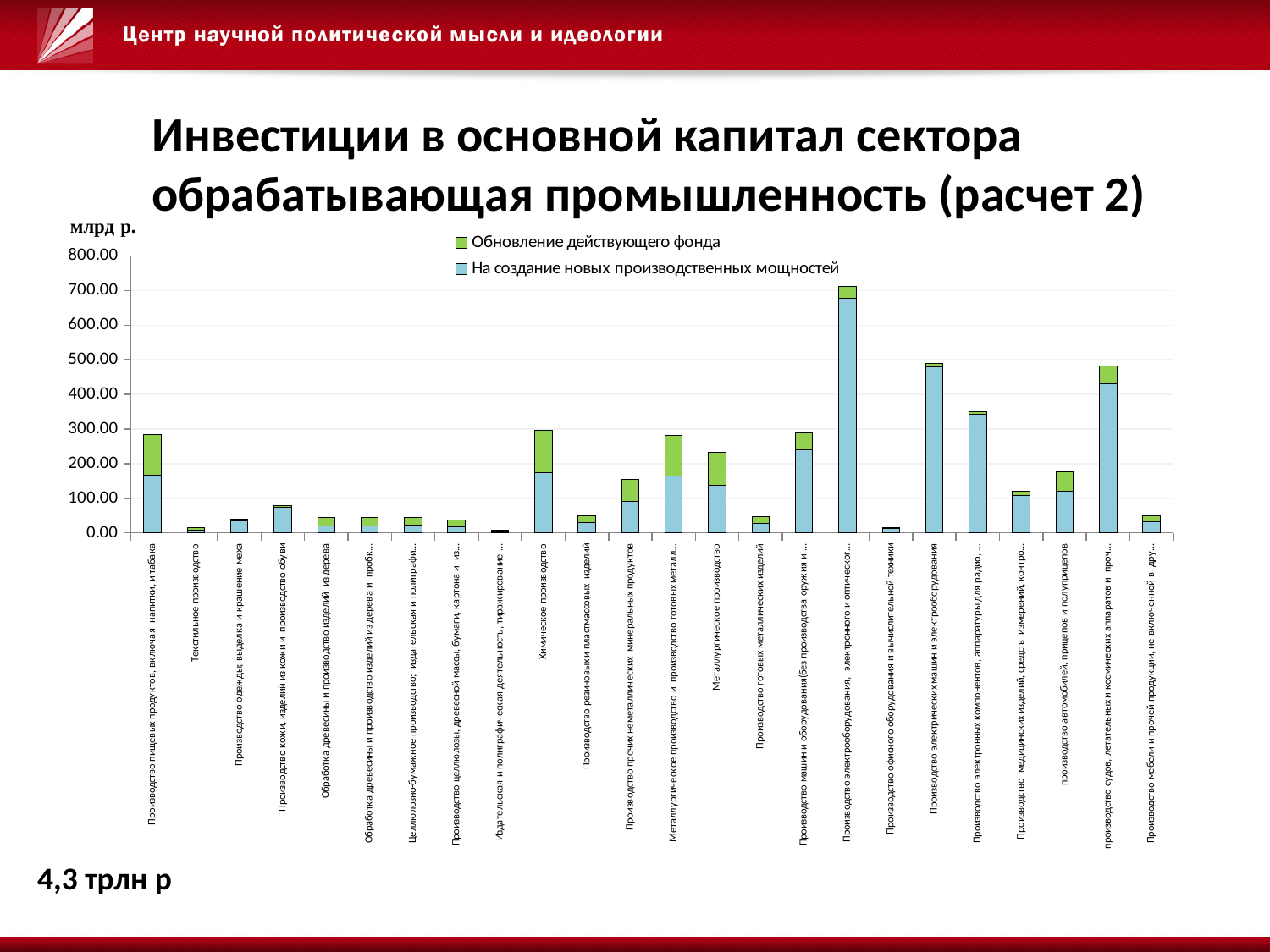
What are the two series named in the chart legend? Обновление действующего фонда; На создание новых производственных мощностей What kind of chart is shown on the slide? Stacked bar chart Which category has the highest total bar on the chart? Производство электрооборудования, электронного и оптического... Is the total value for Производство электрических машин и электрооборудования greater or less than 400? greater Which has the larger total bar: Химическое производство or Металлургическое производство? Химическое производство How many series does the chart legend list? 2 What unit is shown on the vertical axis of the chart? млрд р. Is the total value for Химическое производство greater or less than 200? greater Which has the larger total bar: Производство электрических машин и электрооборудования or Производство электронных компонентов, аппаратуры для радио...? Производство электрических машин и электрооборудования Is the total value for Производство электронных компонентов, аппаратуры для радио... greater or less than 300? greater How many categories (bars) are plotted on the chart? 24